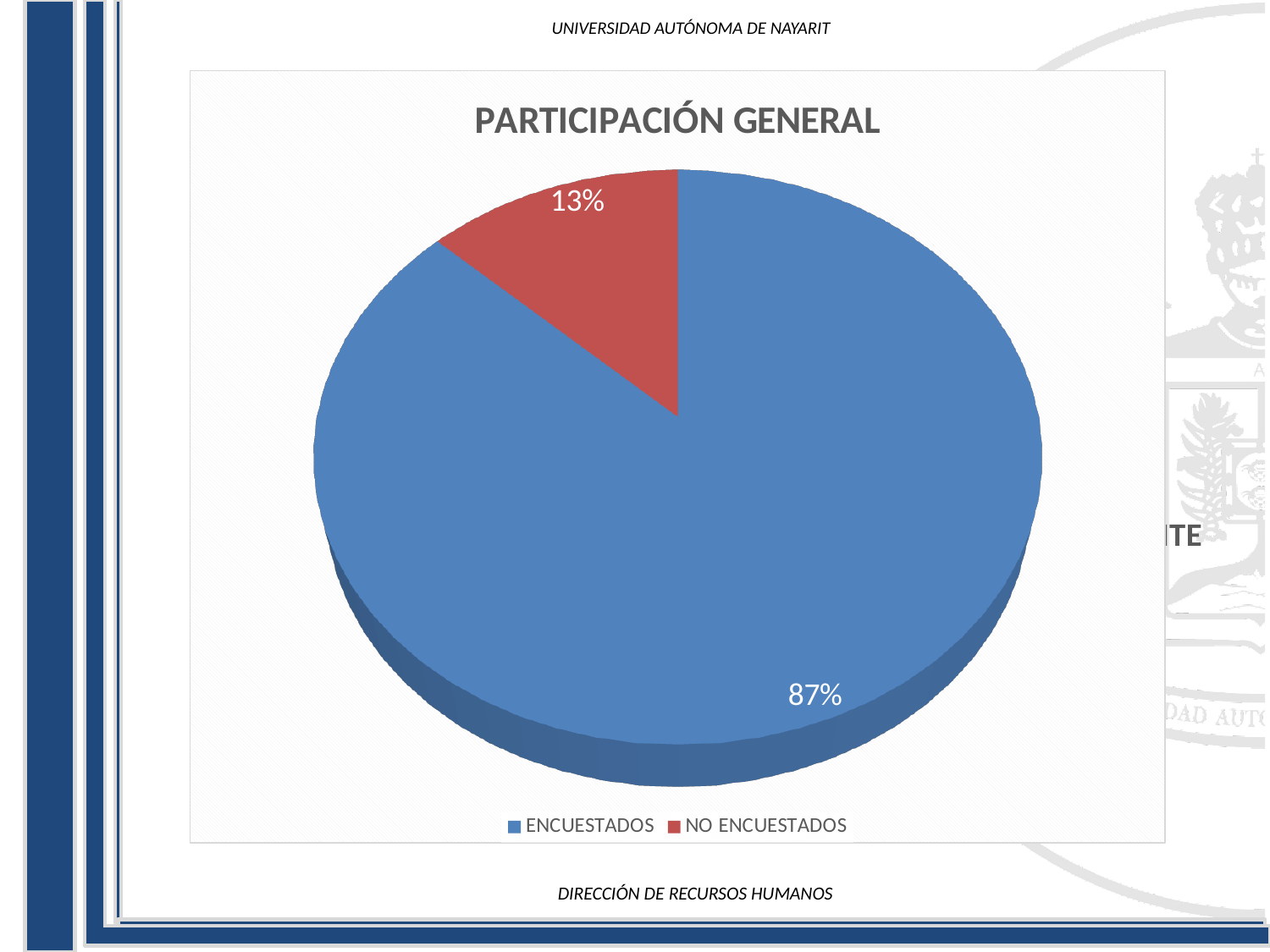
What is the difference in percentage points between ENCUESTADOS and NO ENCUESTADOS? 74 How many entries does the legend list? 2 What share of the pie is ENCUESTADOS? 87% What share of the pie is NO ENCUESTADOS? 13% Which slice is the smallest? NO ENCUESTADOS Which is larger, ENCUESTADOS or NO ENCUESTADOS? ENCUESTADOS What is the title of the chart? PARTICIPACIÓN GENERAL How many slices does the pie chart have? 2 What colour is the NO ENCUESTADOS slice? Red What kind of chart is shown on the slide? Pie chart Which slice is the largest? ENCUESTADOS